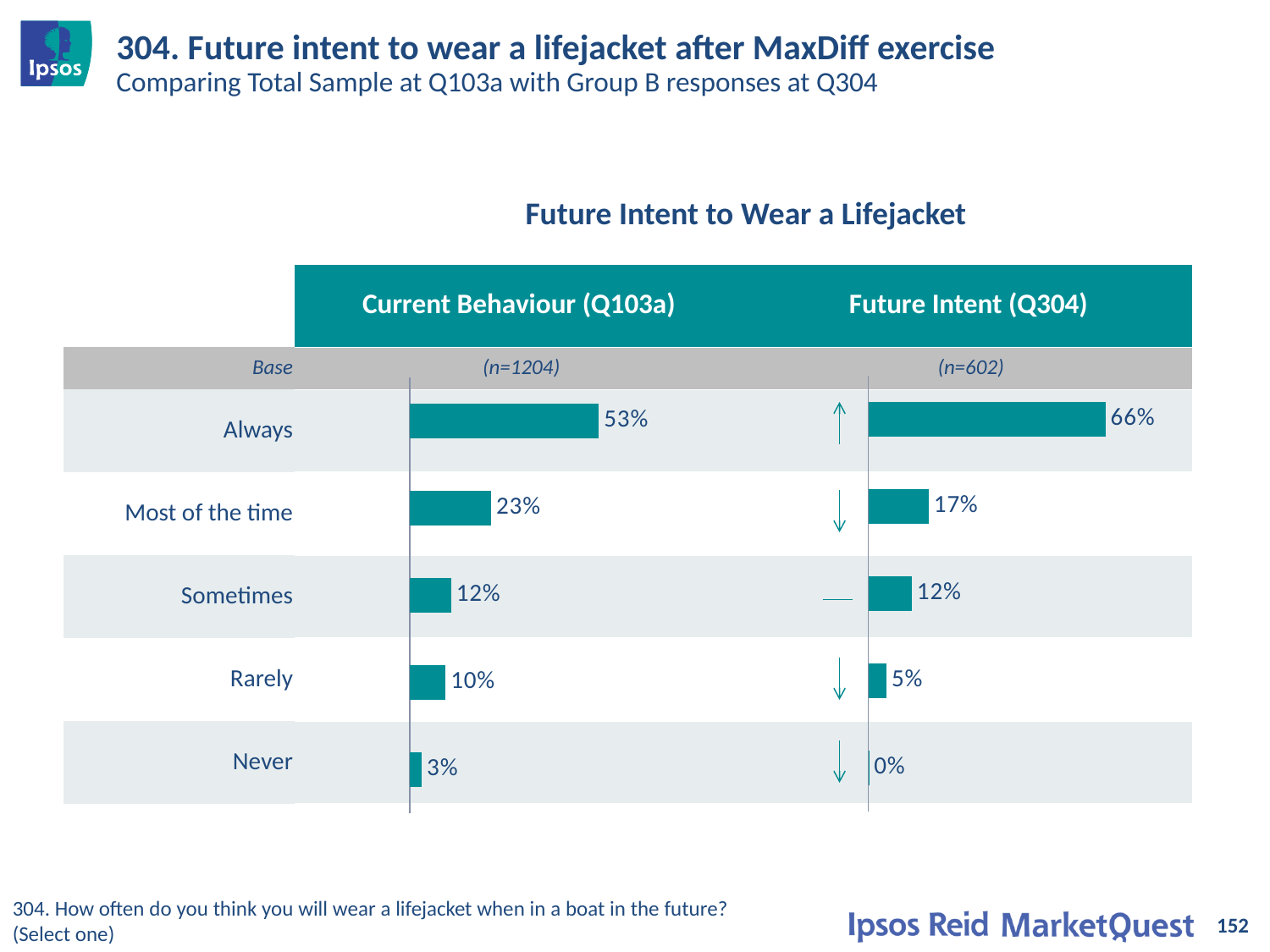
What kind of chart is used to show Future Intent to Wear a Lifejacket? Bar chart In the Current Behaviour (Q103a) chart, what is the value for Always? 53% In the Future Intent (Q304) chart, which category has the lowest value? Never What is the base size shown for the Future Intent (Q304) chart? (n=602) How many categories are shown in the Future Intent to Wear a Lifejacket chart? 5 In the Future Intent (Q304) chart, what is the value for Always? 66% In the Future Intent (Q304) chart, what is the value for Rarely? 5% In the Current Behaviour (Q103a) chart, what is the value for Never? 3% What is the difference between the Current Behaviour (Q103a) and Future Intent (Q304) values for Most of the time? 6% What is the difference between the Future Intent (Q304) and Current Behaviour (Q103a) values for Always? 13% Which is larger: the Current Behaviour (Q103a) value for Rarely or the Future Intent (Q304) value for Rarely? Current Behaviour (Q103a) In the Current Behaviour (Q103a) chart, which category has the highest value? Always